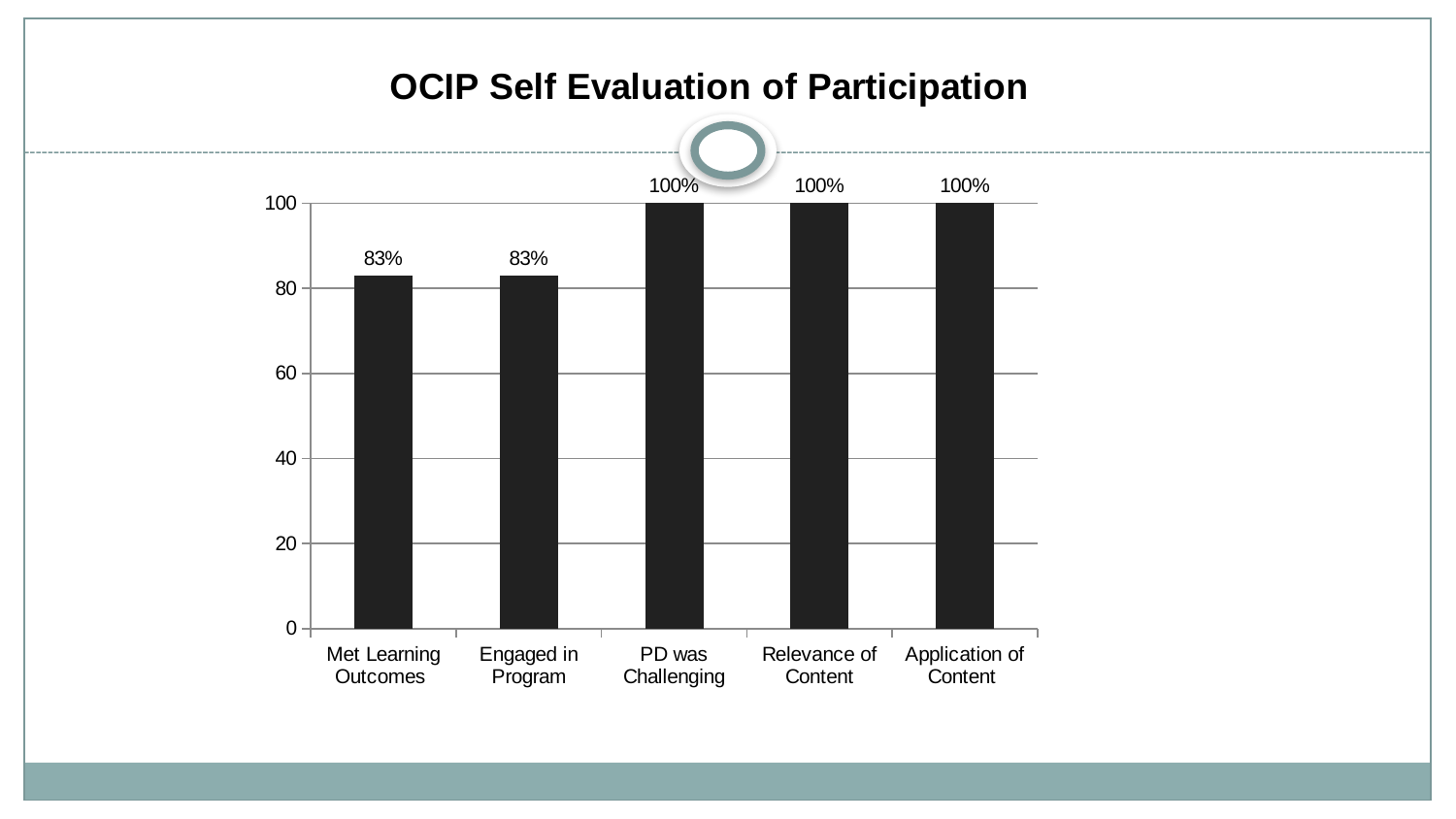
How many categories have a value of 100%? 3 Is the value for Engaged in Program greater or less than 80? greater What is the value for PD was Challenging? 100% What is the value for Met Learning Outcomes? 83% Which is larger, the value for Relevance of Content or the value for Engaged in Program? Relevance of Content What is the difference between the values for PD was Challenging and Met Learning Outcomes? 17% What kind of chart is shown on the slide? bar chart What is the value for Engaged in Program? 83% What is the value for Application of Content? 100% What is the title of the chart? OCIP Self Evaluation of Participation What is the value for Relevance of Content? 100% How many categories are shown on the x axis? 5